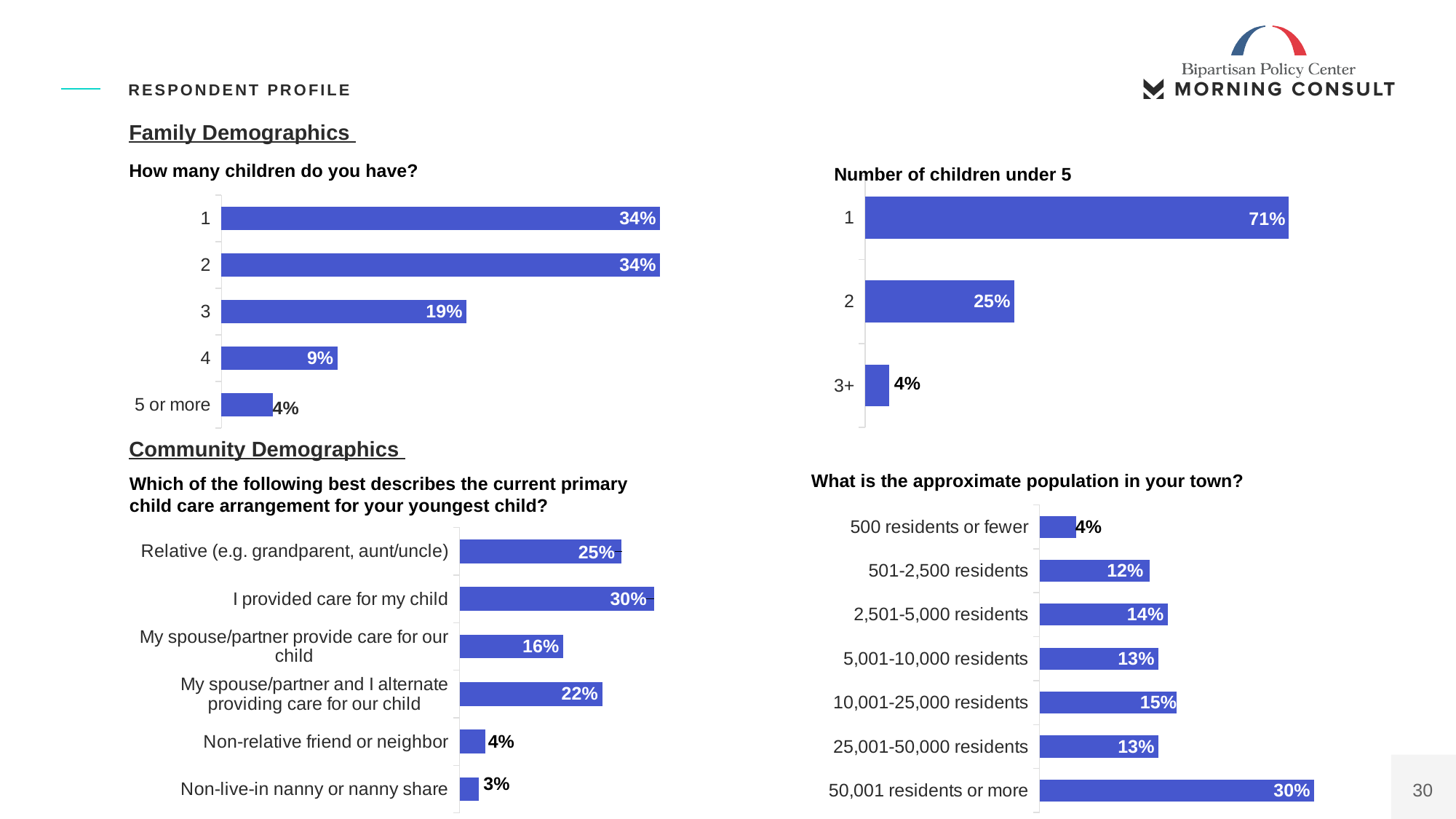
In the 'What is the approximate population in your town?' chart, what is the value for '10,001-25,000 residents'? 15% In the 'How many children do you have?' chart, what percentage of respondents have 3 children? 19% What type of chart is the 'How many children do you have?' chart? Bar chart In the 'What is the approximate population in your town?' chart, which category has the highest value? 50,001 residents or more In the child care arrangement chart, which category has the lowest value? Non-live-in nanny or nanny share In the 'What is the approximate population in your town?' chart, how many categories are shown? 7 In the 'Number of children under 5' chart, how many categories are shown? 3 In the child care arrangement chart, which is larger: 'Relative (e.g. grandparent, aunt/uncle)' or 'My spouse/partner and I alternate providing care for our child'? Relative (e.g. grandparent, aunt/uncle) In the 'Number of children under 5' chart, what is the difference between the values for 1 and 2 children? 46% In the child care arrangement chart, what is the value for 'I provided care for my child'? 30% In the 'Number of children under 5' chart, which category has the highest value? 1 In the 'How many children do you have?' chart, what is the value for '5 or more'? 4%